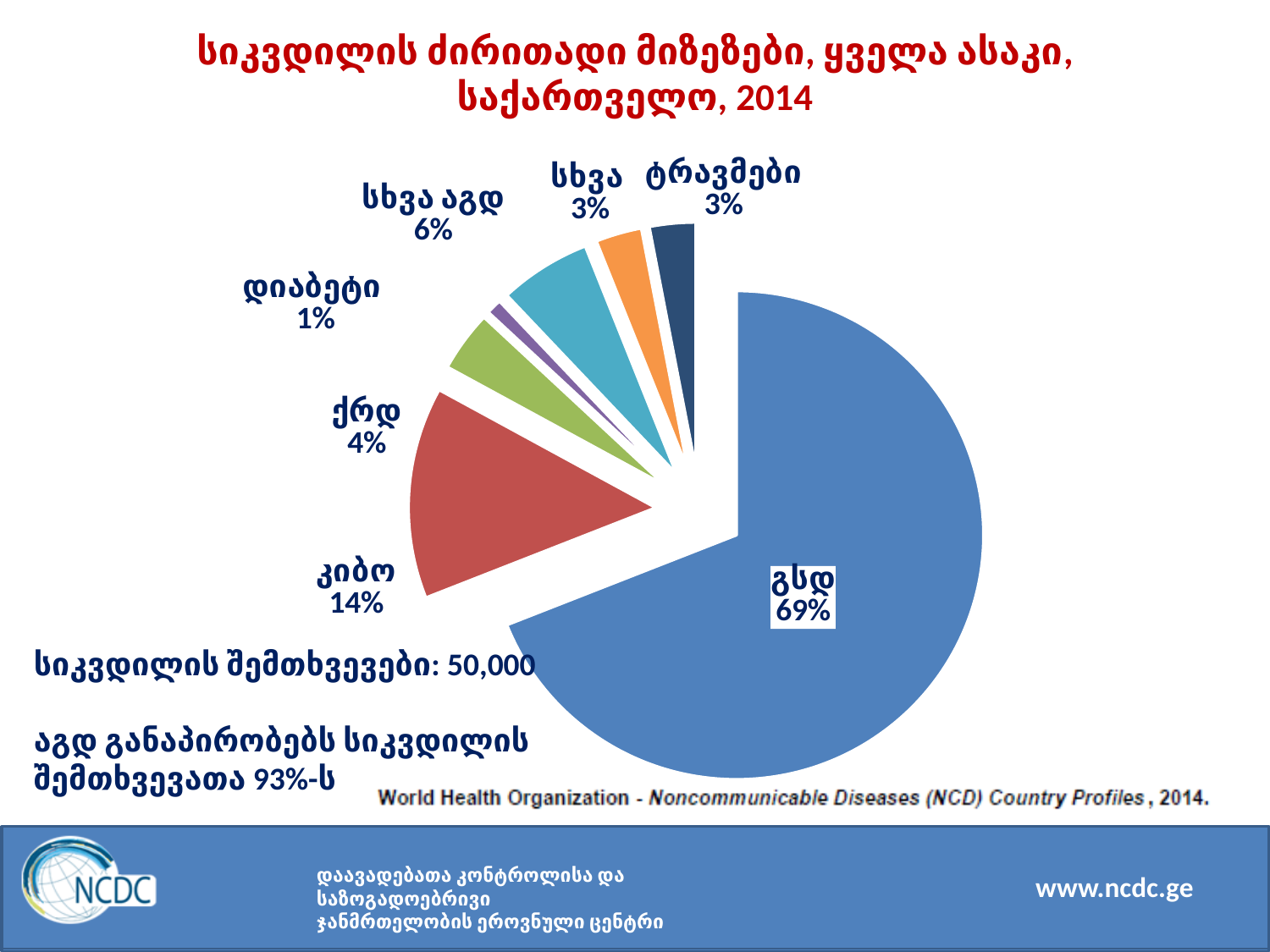
What share of the pie does გსდ account for? 69% What is the value shown for ქრდ? 4% Which is larger, the slice for კიბო or the slice for სხვა აგდ? კიბო Which category has the smallest slice of the pie? დიაბეტი What is the difference in percentage points between გსდ and კიბო? 55 Which category has the largest slice of the pie? გსდ What is the value shown for დიაბეტი? 1% What is the value shown for სხვა აგდ? 6% How many slices does the pie chart have? 7 What is the value shown for კიბო? 14% What year is given in the chart title? 2014 What kind of chart is shown on the slide? pie chart